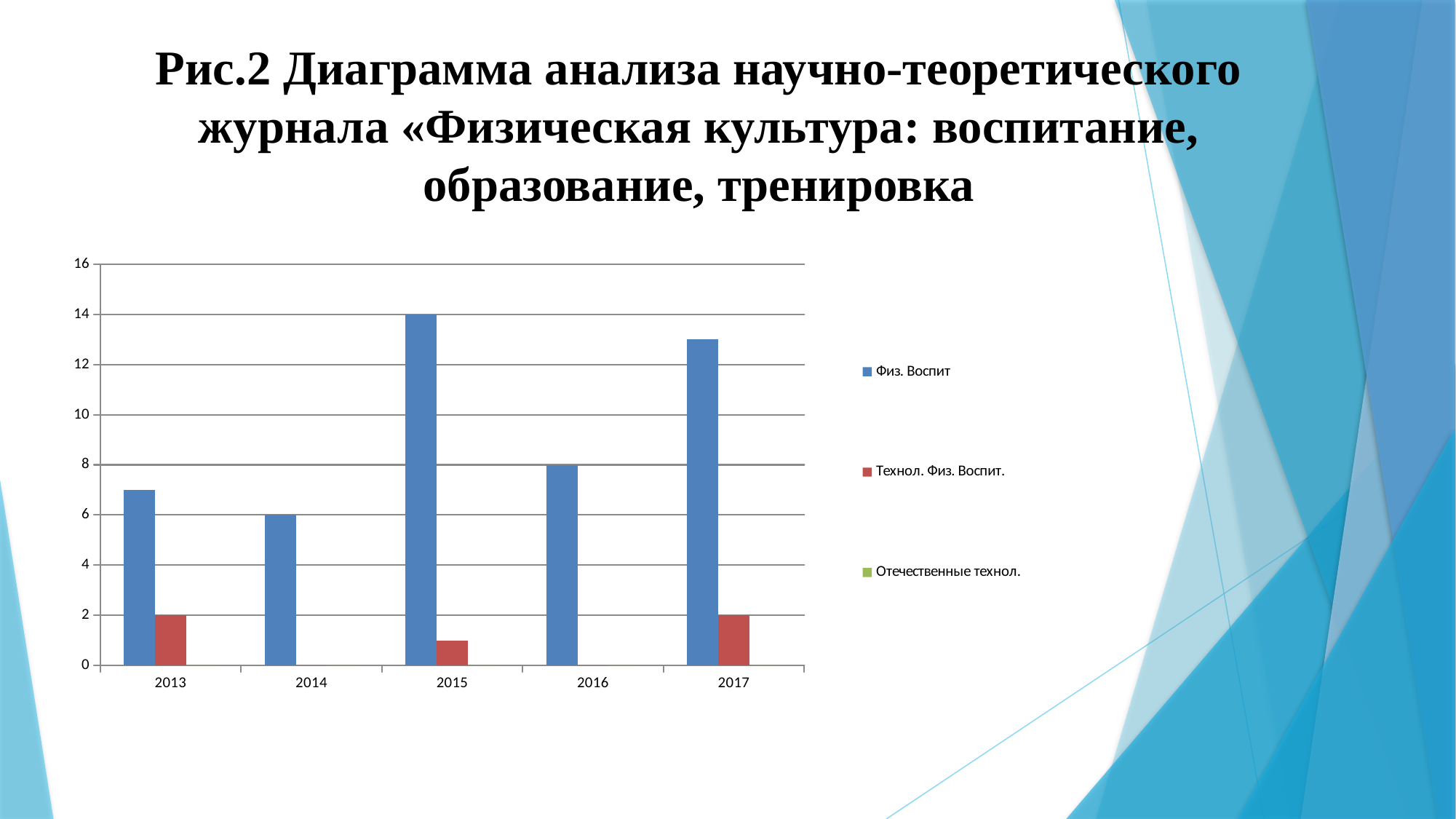
How many series does the legend list? 3 How many years are shown on the x axis? 5 In which year is the Физ. Воспит value highest? 2015 What is the value for Физ. Воспит in 2016? 8 What is the value for Физ. Воспит in 2015? 14 What is the value for Физ. Воспит in 2014? 6 In which year is the Физ. Воспит value lowest? 2014 Which is larger, the Физ. Воспит value in 2013 or in 2016? 2016 What is the value for Технол. Физ. Воспит. in 2013? 2 Is the value for Физ. Воспит in 2017 greater or less than 12? greater What is the difference between the Физ. Воспит values in 2015 and 2014? 8 What kind of chart is shown on the slide? bar chart